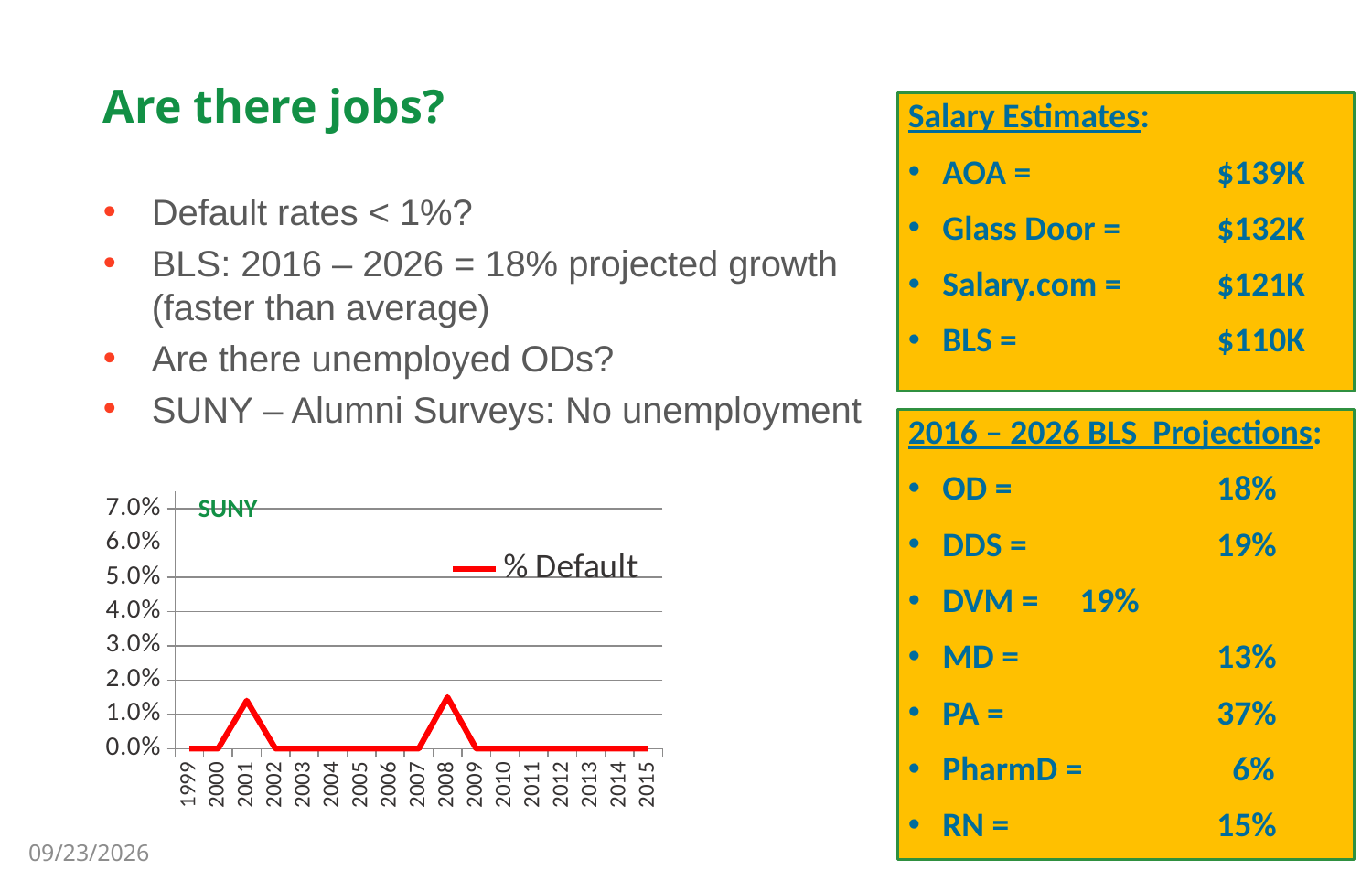
Is the % Default value for 2008 greater or less than 2.0%? less Is the % Default value for 2001 greater or less than 1.0%? greater Which is larger, the % Default value for 2008 or for 2010? 2008 What is the name of the series shown in the chart's legend? % Default Is the % Default value for 2008 greater or less than 1.0%? greater How many series does the chart's legend list? 1 How many years are plotted along the x axis of the chart? 17 What is the % Default value for 2005? 0.0% What is the % Default value for 1999? 0.0% What is the title of the chart on the slide? SUNY What is the % Default value for 2015? 0.0% What kind of chart is shown on the slide? line chart